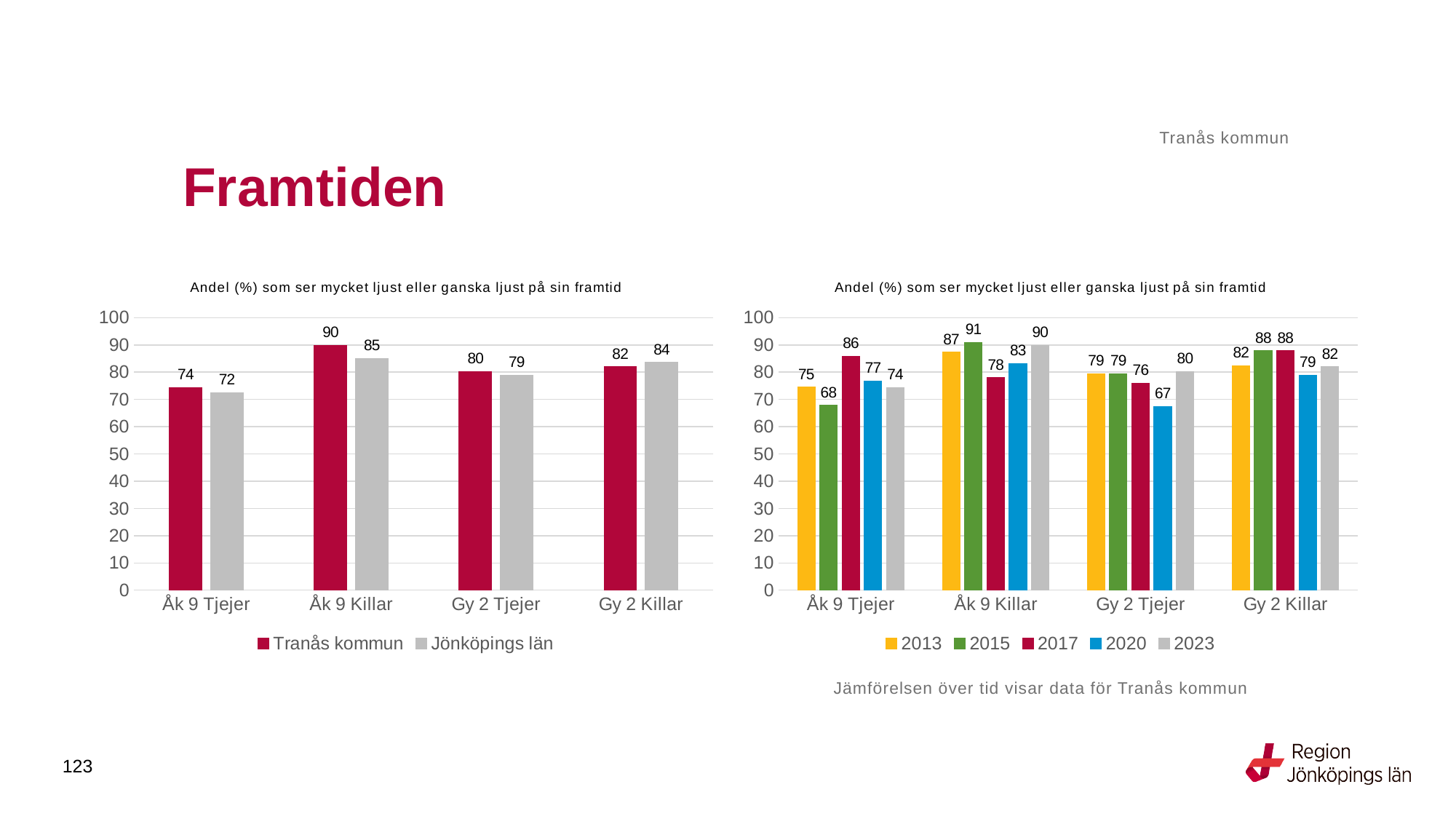
In the right chart, what is the difference between the 2023 and 2013 values for Åk 9 Tjejer? 1 In the left chart, what is the value for Jönköpings län for Gy 2 Tjejer? 79 In the right chart, which year has the lowest value for Åk 9 Tjejer? 2015 What kind of chart is the right chart? Bar chart In the left chart, which category has the highest value for Tranås kommun? Åk 9 Killar In the left chart, how many series does the legend list? 2 In the right chart, how many series does the legend list? 5 In the left chart, what is the value for Tranås kommun for Åk 9 Killar? 90 In the right chart, what is the value for 2015 for Åk 9 Killar? 91 In the right chart, what is the value for 2020 for Gy 2 Tjejer? 67 In the left chart, what is the difference between Tranås kommun and Jönköpings län for Åk 9 Killar? 5 In the left chart, which is larger for Gy 2 Killar: Tranås kommun or Jönköpings län? Jönköpings län